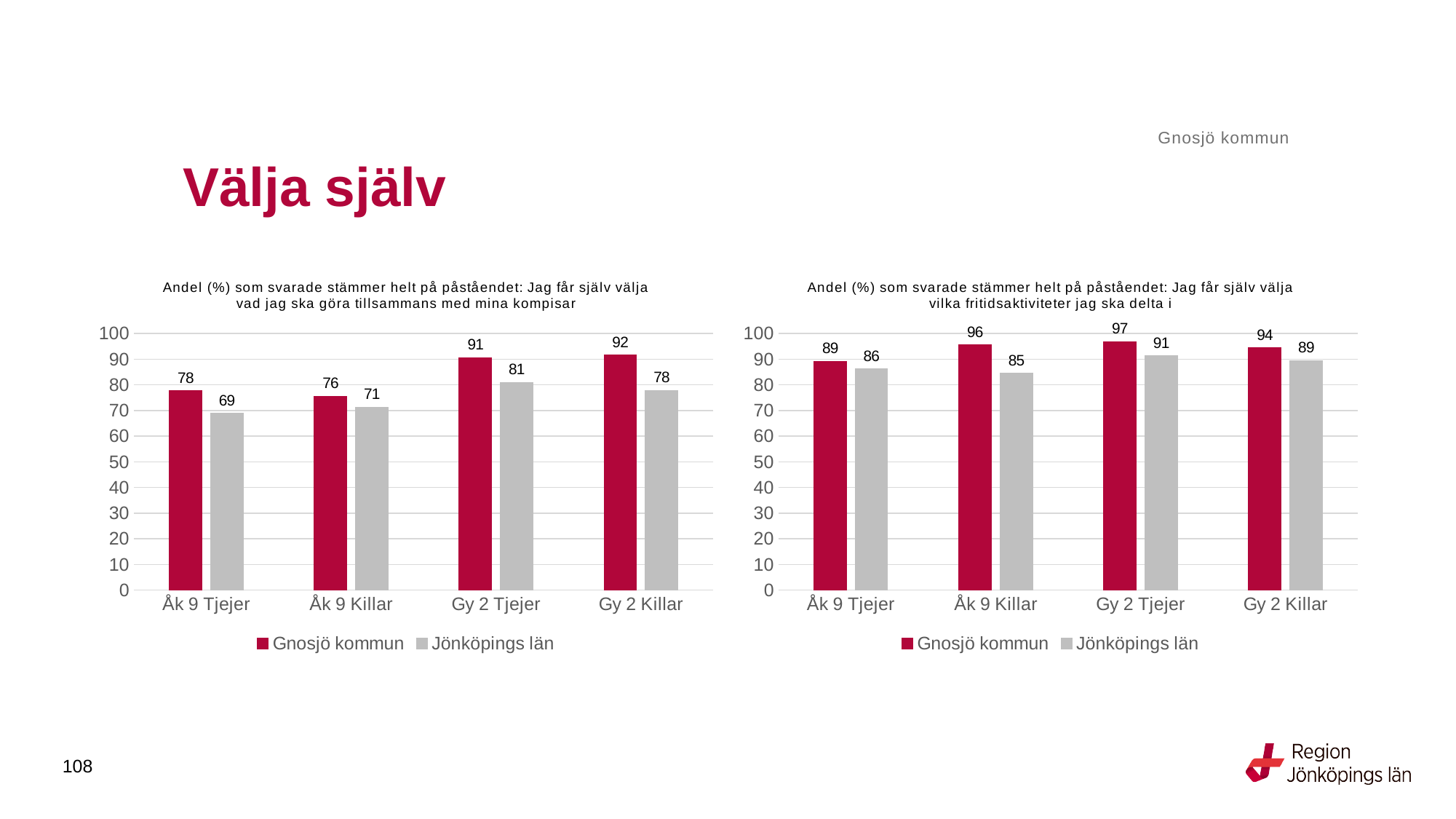
In the left chart (about choosing what to do with friends), which is larger for Åk 9 Killar: Gnosjö kommun or Jönköpings län? Gnosjö kommun What kind of chart is the right chart (about choosing leisure activities)? Bar chart How many series does the legend of the left chart (about choosing what to do with friends) list? 2 In the left chart (about choosing what to do with friends), what is the value for Gnosjö kommun for Åk 9 Tjejer? 78 In the right chart (about choosing leisure activities), what is the value for Jönköpings län for Gy 2 Killar? 89 In the right chart (about choosing leisure activities), what is the difference between Gnosjö kommun and Jönköpings län for Åk 9 Killar? 11 In the left chart (about choosing what to do with friends), what is the difference between Gnosjö kommun and Jönköpings län for Gy 2 Killar? 14 How many categories are shown on the x axis of the right chart (about choosing leisure activities)? 4 In the right chart (about choosing leisure activities), what is the value for Gnosjö kommun for Åk 9 Killar? 96 In the left chart (about choosing what to do with friends), what is the value for Jönköpings län for Gy 2 Tjejer? 81 In the right chart (about choosing leisure activities), which category has the lowest Jönköpings län value? Åk 9 Killar In the left chart (about choosing what to do with friends), which category has the highest Gnosjö kommun value? Gy 2 Killar